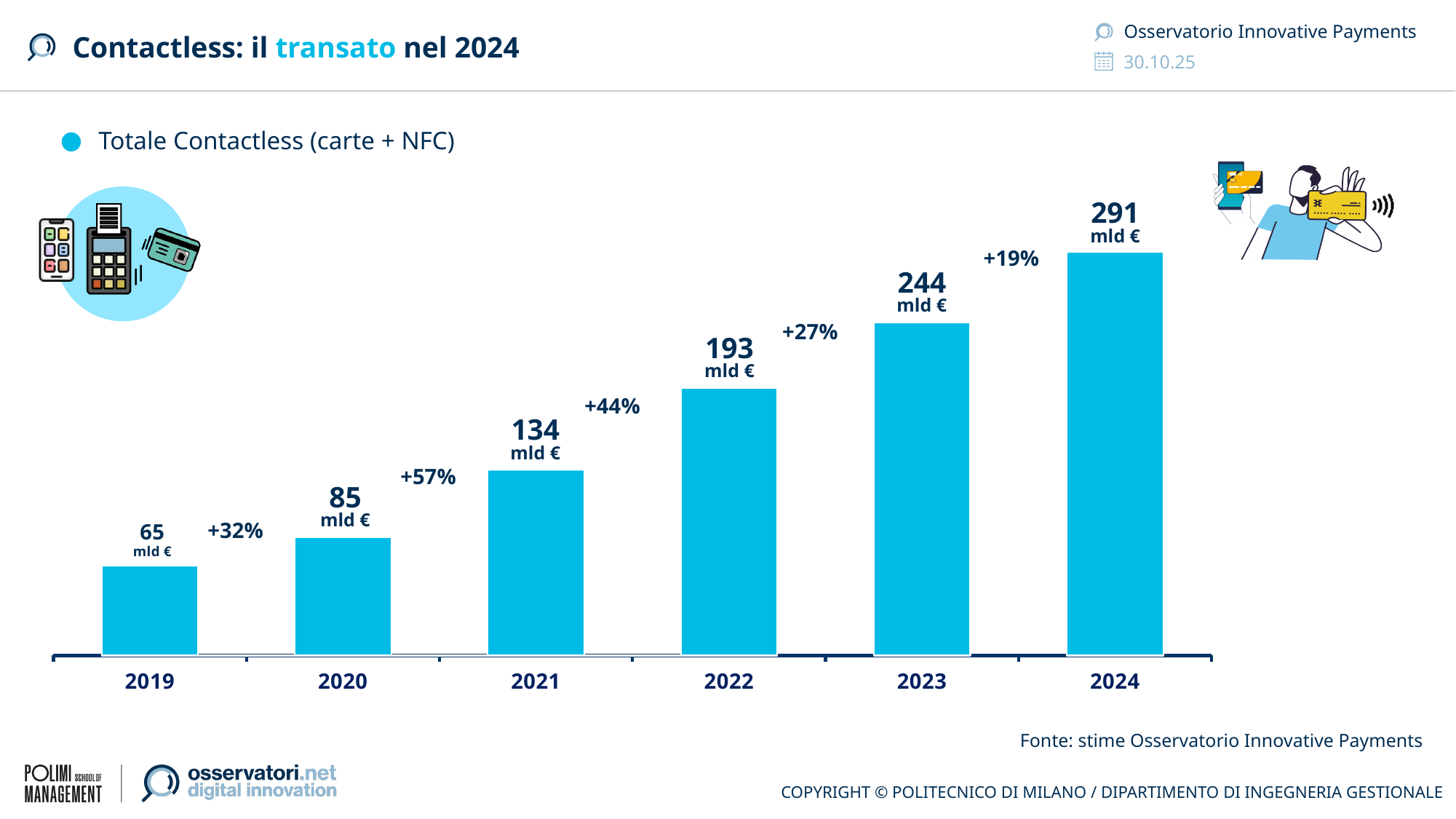
What growth percentage is shown between 2020 and 2021? +57% What is the value for 2019? 65 mld € What kind of chart is this? Bar chart Which is larger, the value for 2021 or the value for 2020? 2021 Which year has the highest value? 2024 Which year has the lowest value? 2019 What is the value for 2022? 193 mld € What growth percentage is shown between 2023 and 2024? +19% What is the value for 2024? 291 mld € Do the values rise or fall from 2019 to 2024? Rise What is the difference between the 2024 and 2023 values? 47 mld € How many years are shown on the x axis? 6